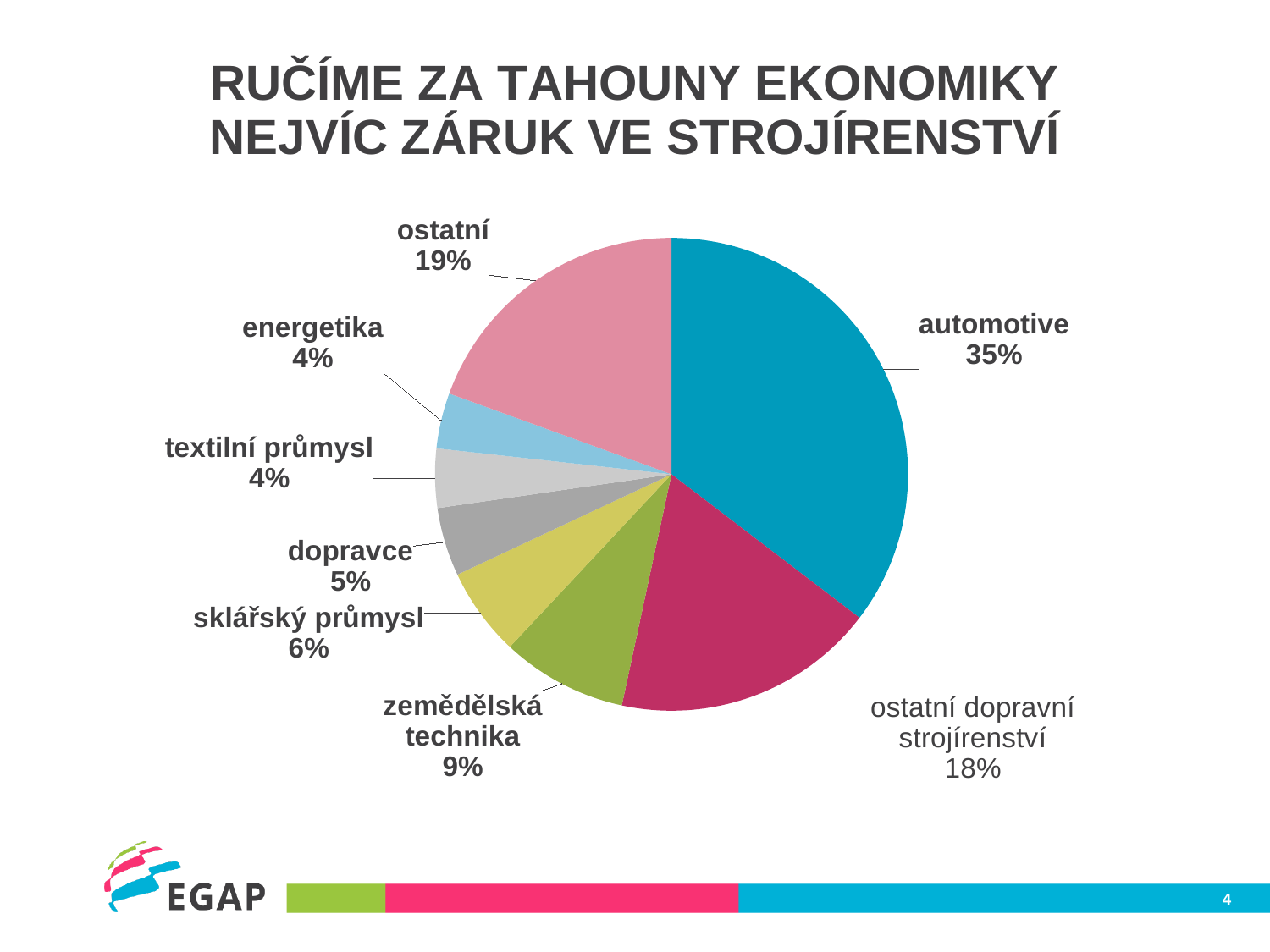
What is the difference between the shares of ostatní and zemědělská technika? 10% What is the value for sklářský průmysl? 6% What is the value for zemědělská technika? 9% What share of the pie does automotive have? 35% What is the value for ostatní dopravní strojírenství? 18% Which is larger, the share for dopravce or the share for sklářský průmysl? sklářský průmysl What is the difference between the shares of automotive and ostatní dopravní strojírenství? 17% Which category has the largest share of the pie? automotive What is the value for ostatní? 19% What is the title of the slide containing the chart? RUČÍME ZA TAHOUNY EKONOMIKY NEJVÍC ZÁRUK VE STROJÍRENSTVÍ What kind of chart is shown on the slide? pie chart How many slices does the pie chart have? 8